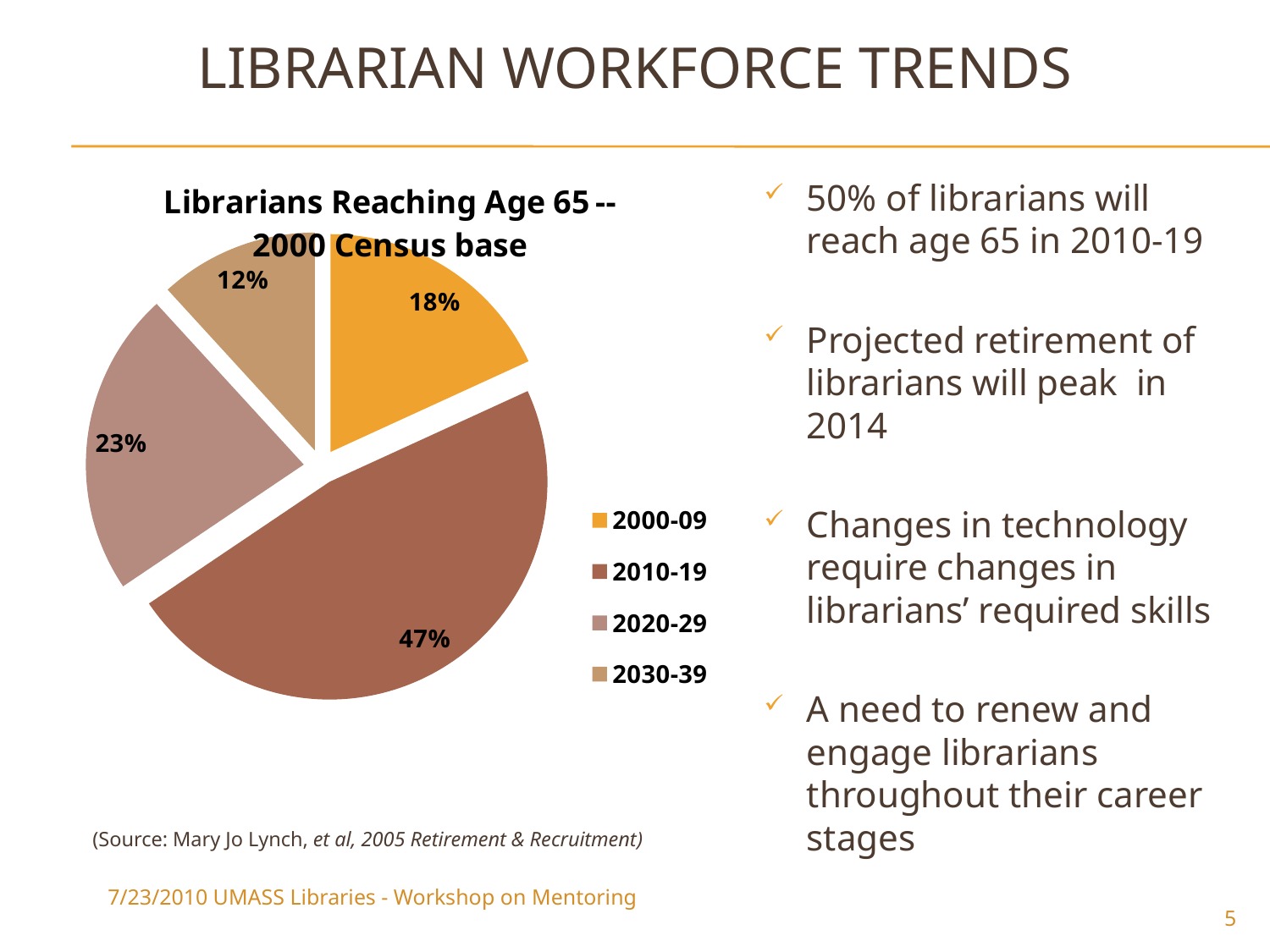
Which decade has the smallest share of librarians reaching age 65? 2030-39 What kind of chart is shown on the slide? pie chart What percentage of librarians reach age 65 in 2020-29? 23% What percentage of librarians reach age 65 in 2030-39? 12% What is the title of the chart? Librarians Reaching Age 65 -- 2000 Census base How many slices does the pie chart have? 4 What percentage of librarians reach age 65 in 2000-09? 18% How many entries does the legend list? 4 What percentage of librarians reach age 65 in 2010-19? 47% Which decade has the largest share of librarians reaching age 65? 2010-19 What is the difference in percentage points between the 2010-19 slice and the 2020-29 slice? 24 Which slice is larger, 2000-09 or 2020-29? 2020-29